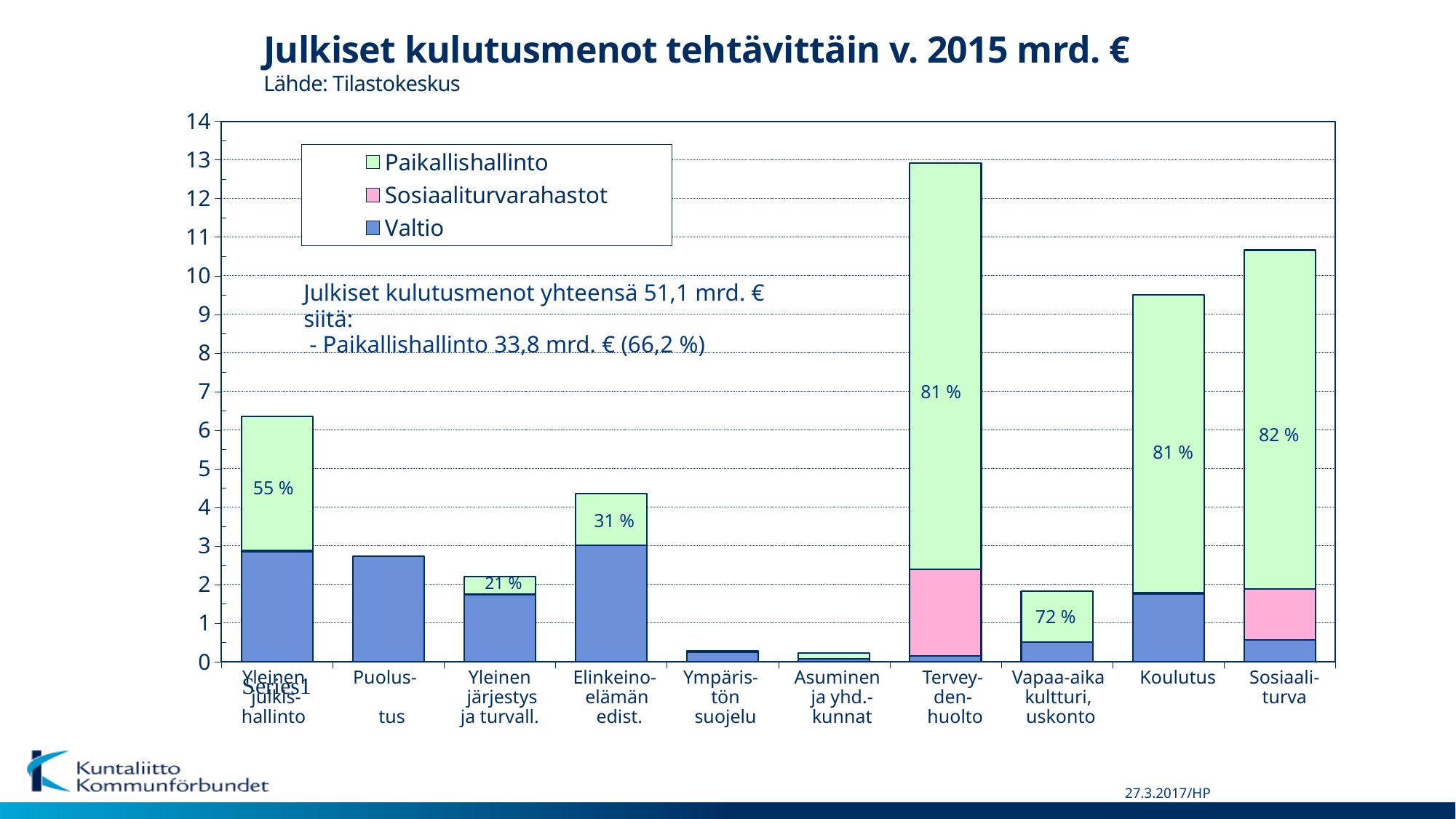
Is the total bar for Puolustus greater or less than 3? less What percentage label is shown on the Paikallishallinto segment for Terveydenhuolto? 81 % What percentage label is shown on the Paikallishallinto segment for Vapaa-aika, kulttuuri, uskonto? 72 % What percentage label is shown on the Paikallishallinto segment for Sosiaaliturva? 82 % How many series does the legend list? 3 What kind of chart is shown on the slide? stacked bar chart By how many percentage points does the Paikallishallinto label for Sosiaaliturva exceed the label for Yleinen julkishallinto? 27 Which category has the tallest stacked bar? Terveydenhuolto Which has the taller stacked bar, Koulutus or Sosiaaliturva? Sosiaaliturva How many categories are shown on the x axis? 10 What percentage label is shown on the Paikallishallinto segment for Yleinen järjestys ja turvall.? 21 % Is the total bar for Terveydenhuolto greater or less than 12? greater